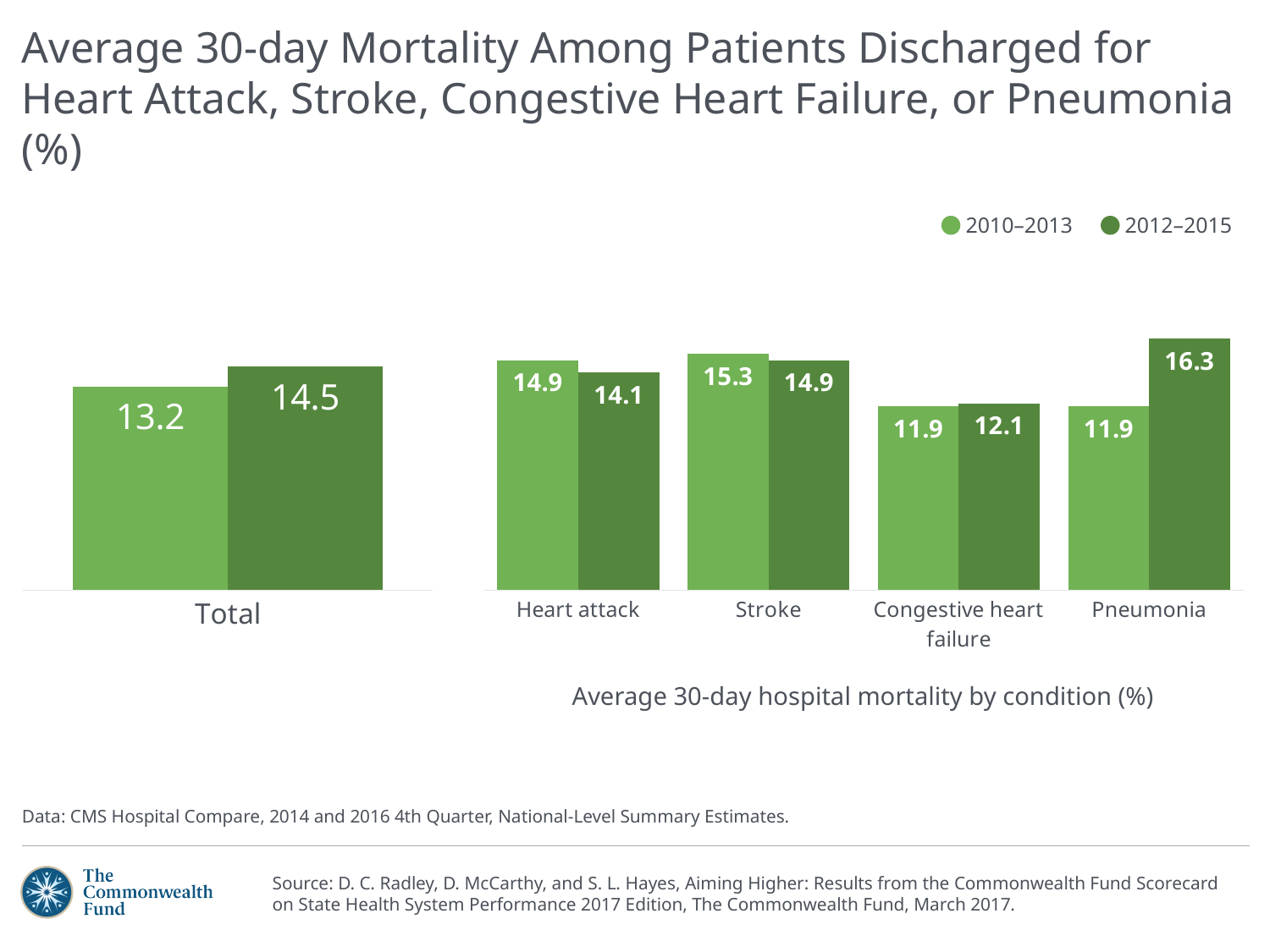
In the left chart (Total), what is the value for 2012–2015? 14.5 In the right chart (by condition), which condition has the lowest 2012–2015 value? Congestive heart failure In the right chart (by condition), what is the 2010–2013 value for Stroke? 15.3 In the right chart (by condition), what is the 2012–2015 value for Pneumonia? 16.3 How many series does the legend list? 2 In the right chart (by condition), which condition has the highest 2012–2015 value? Pneumonia In the right chart (by condition), which is larger for Heart attack: the 2010–2013 value or the 2012–2015 value? 2010–2013 How many conditions are shown on the x axis of the right chart (by condition)? 4 In the left chart (Total), what is the difference between the 2012–2015 and 2010–2013 values? 1.3 In the right chart (by condition), what is the difference between the 2012–2015 and 2010–2013 values for Pneumonia? 4.4 In the left chart (Total), what is the value for 2010–2013? 13.2 What kind of chart is the right chart (by condition)? Bar chart